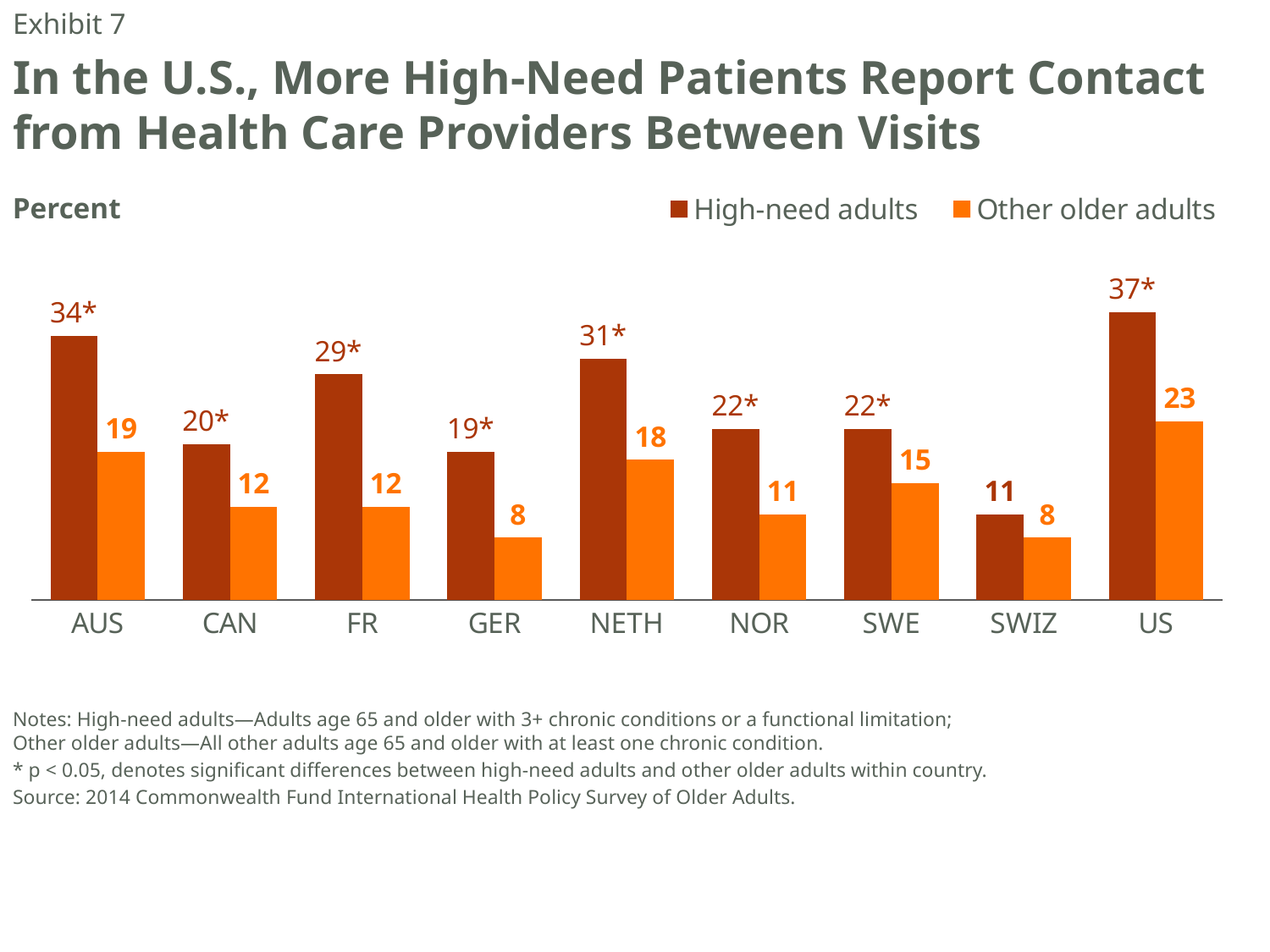
How many series does the legend list? 2 Which country has the lowest value for Other older adults? GER and SWIZ Which country has the highest value for High-need adults? US What is the value for High-need adults in SWIZ? 11 What kind of chart is shown on the slide? Bar chart How many countries are shown on the x axis? 9 What is the value for Other older adults in NETH? 18 What is the value for High-need adults in the US? 37 What is the difference between High-need adults and Other older adults in AUS? 15 Which is larger: the Other older adults value for SWE or for NOR? SWE What is the difference between the High-need adults values for US and SWIZ? 26 What colour are the bars for Other older adults? Orange